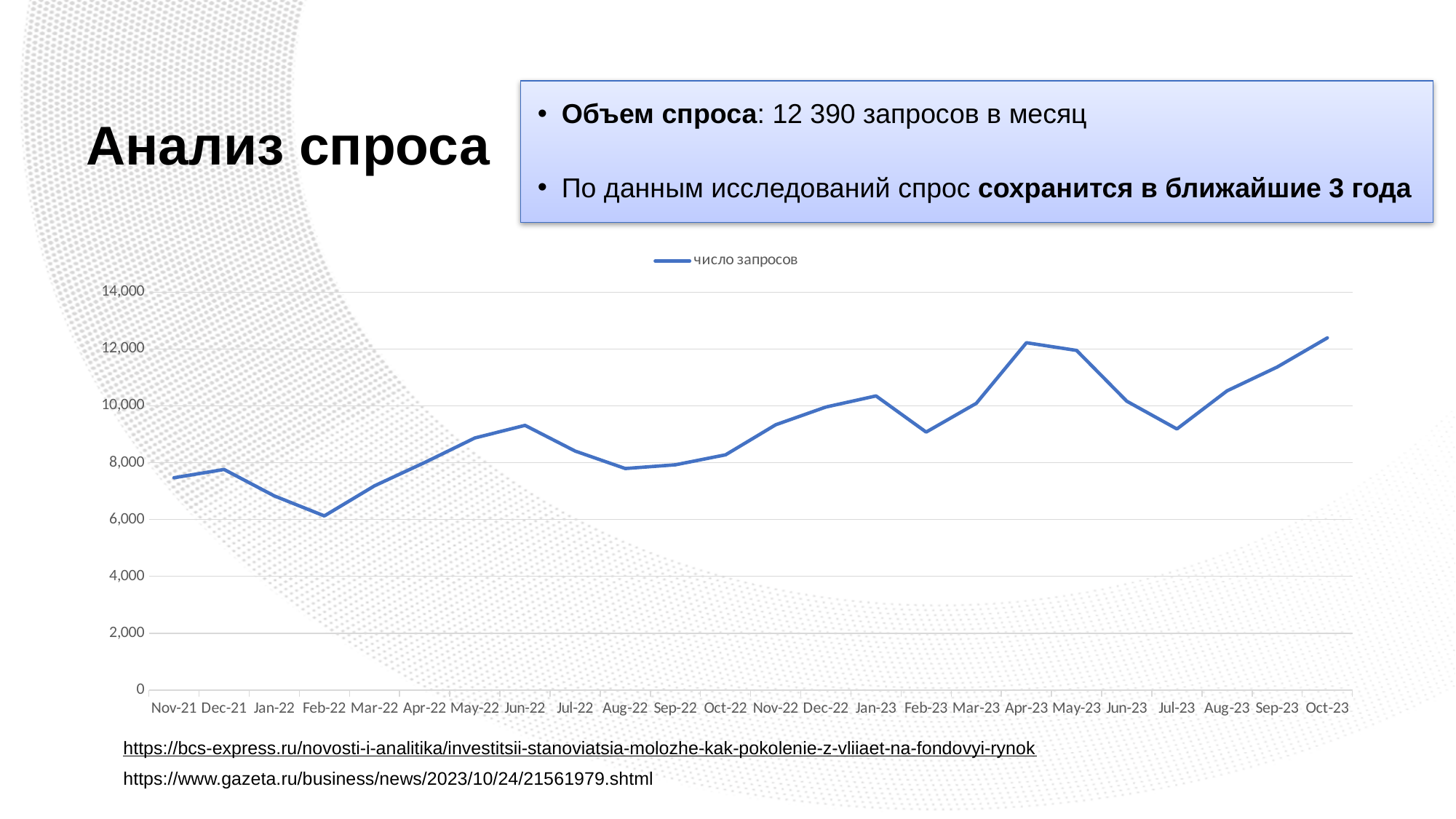
Is the value for Feb-22 greater or less than 8,000? less Is the value for Apr-23 greater or less than 12,000? greater Is the value for Jan-23 greater or less than 10,000? greater What is the name of the series shown in the chart legend? число запросов How many series does the chart legend list? 1 What kind of chart is shown on the slide? line chart How many months are plotted along the x axis of the chart? 24 Which is larger, the value for Jun-22 or the value for Aug-22? Jun-22 Do the values rise or fall from Apr-23 to Jul-23? fall Which month has the lowest number of requests in the chart? Feb-22 Do the values rise or fall from Feb-22 to Jun-22? rise